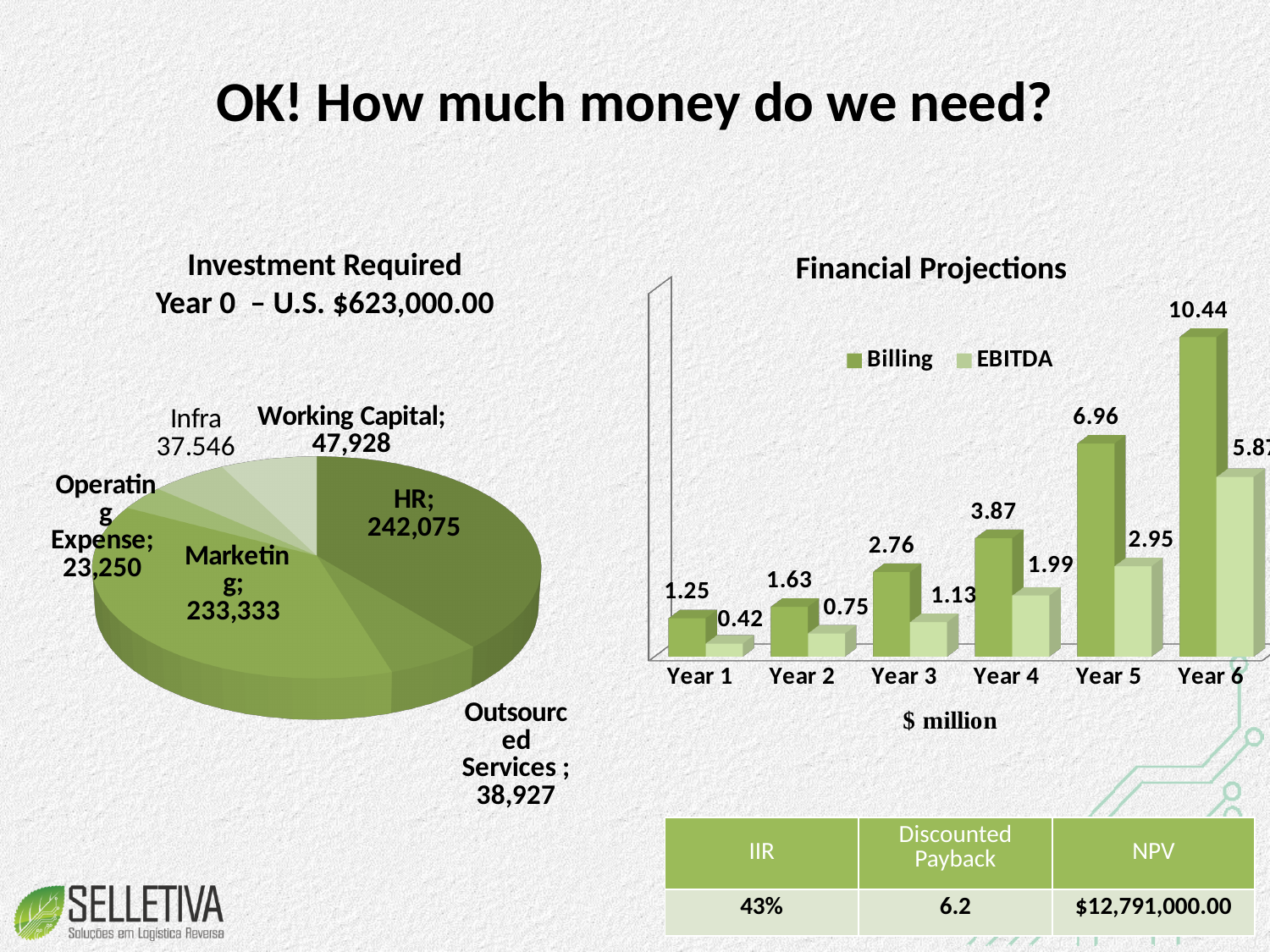
In the Financial Projections chart, what is the Billing value for Year 3? 2.76 What kind of chart is the Investment Required chart? pie chart In the Investment Required pie chart, what is the value for HR? 242,075 In the Financial Projections chart, what is the EBITDA value for Year 4? 1.99 In the Financial Projections chart, which year has the highest Billing value? Year 6 In the Financial Projections chart, what is the difference between the Billing values for Year 5 and Year 4? 3.09 In the Investment Required pie chart, which category has the smallest value? Operating Expense What kind of chart is the Financial Projections chart? bar chart In the Investment Required pie chart, which is larger: Marketing or Working Capital? Marketing How many years are shown on the x axis of the Financial Projections chart? 6 How many series does the legend of the Financial Projections chart list? 2 In the Financial Projections chart, do the Billing values rise or fall from Year 1 to Year 6? rise